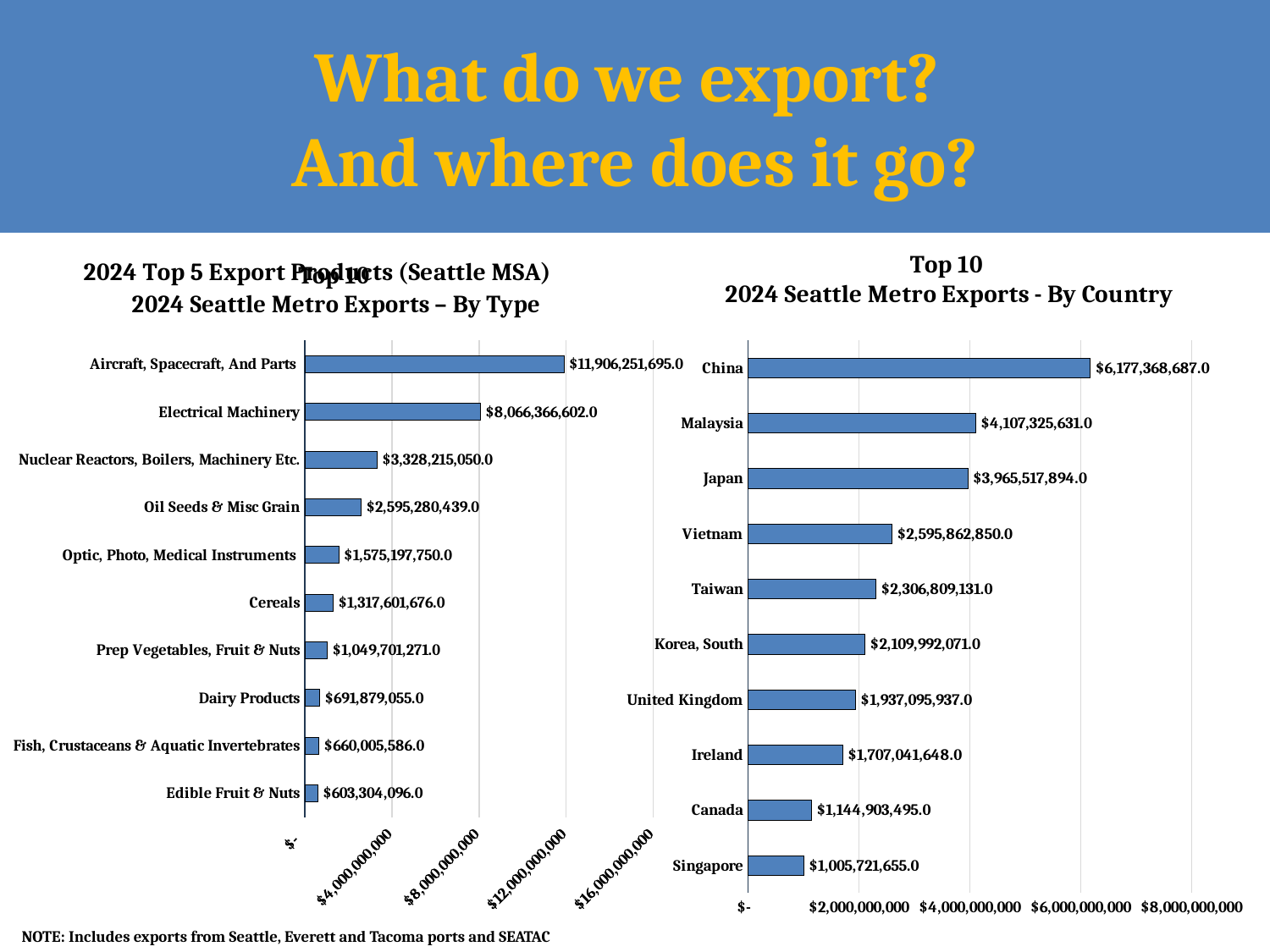
In the left chart (exports by type), which is larger: Cereals or Dairy Products? Cereals In the right chart (exports by country), is the value for Vietnam greater or less than $2,000,000,000? greater In the right chart (exports by country), which country has the highest export value? China In the right chart (exports by country), what is the value for Japan? $3,965,517,894.0 In the left chart (exports by type), what is the value for Electrical Machinery? $8,066,366,602.0 In the left chart (exports by type), which product category has the lowest export value? Edible Fruit & Nuts What kind of chart is the right chart (exports by country)? Bar chart How many product categories are shown in the left chart (exports by type)? 10 In the right chart (exports by country), what is the difference between the values for China and Malaysia? $2,070,043,056.0 How many countries are shown in the right chart (exports by country)? 10 In the right chart (exports by country), what is the value for Singapore? $1,005,721,655.0 In the left chart (exports by type), what is the value for Oil Seeds & Misc Grain? $2,595,280,439.0